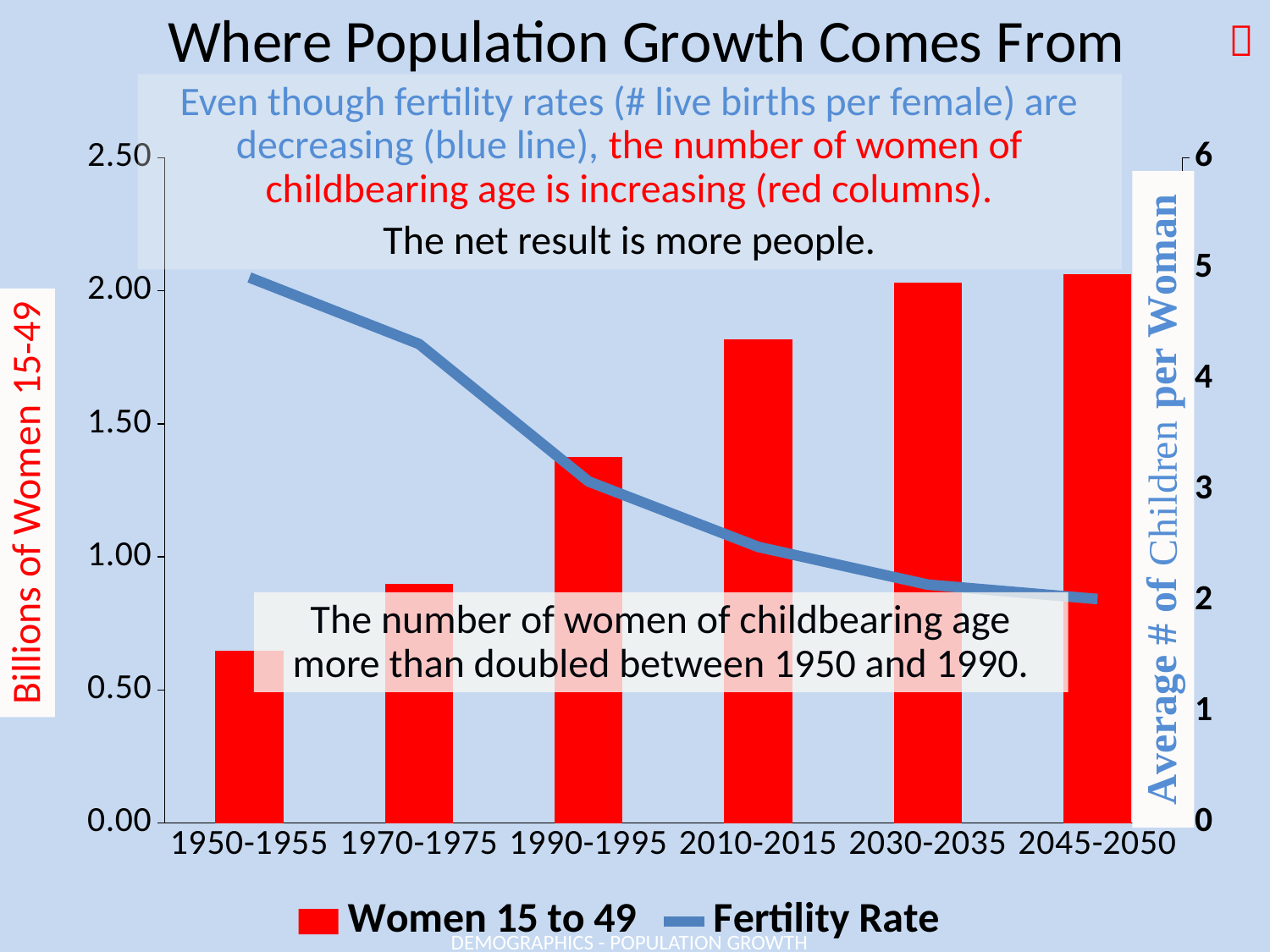
What kind of chart is shown on the slide? A combination bar and line chart How many series does the legend list? 2 How many time periods are shown on the x axis? 6 What is the title of the chart? Where Population Growth Comes From Is the value for Women 15 to 49 in 2010-2015 greater or less than 1.50? greater Which series is drawn as red bars? Women 15 to 49 Which period has the lowest value for Women 15 to 49? 1950-1955 Which is larger, the Fertility Rate in 1970-1975 or in 2030-2035? 1970-1975 Does the Fertility Rate line rise or fall from 1950-1955 to 2045-2050? Fall Which period has the highest Fertility Rate? 1950-1955 Is the Fertility Rate in 2045-2050 greater or less than 3? less Is the value for Women 15 to 49 in 1950-1955 greater or less than 1.00? less